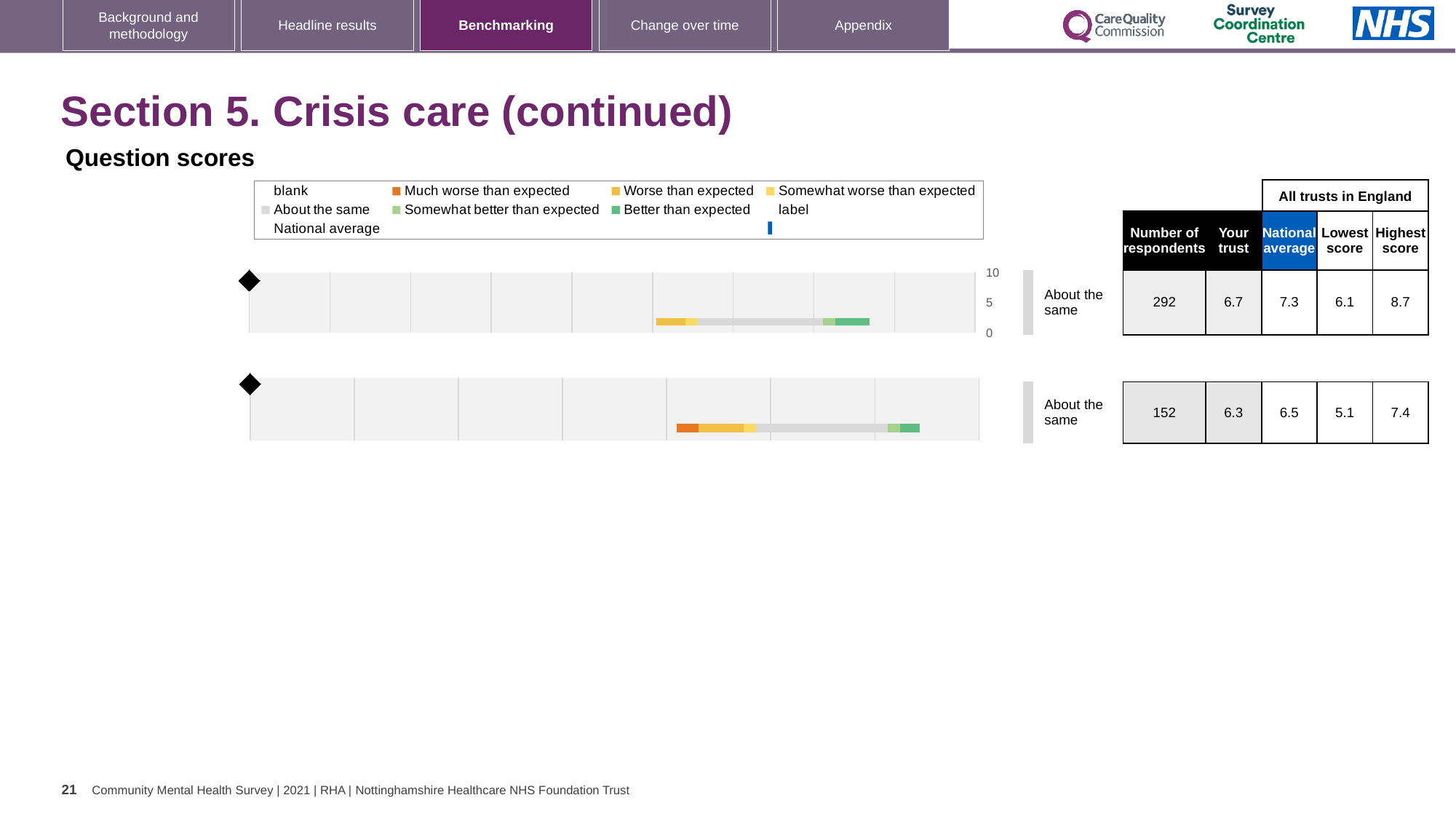
How many respondents are listed for the top chart? 292 In the bottom chart, what is the difference between the national average (6.5) and the 'Your trust' score (6.3)? 0.2 In the top chart, which is larger: the 'Your trust' score or the national average? National average In the top chart, what is the national average score? 7.3 What benchmark category is shown next to both charts? About the same In the top chart, what is the 'Your trust' score shown in the table? 6.7 In the bottom chart, what is the 'Your trust' score? 6.3 In the bottom chart, what is the highest score among all trusts in England? 7.4 How many question score charts are shown on the slide? 2 In the top chart, what is the difference between the highest score (8.7) and the lowest score (6.1)? 2.6 What kind of chart is used to show the question scores on this slide? Bar chart In the bottom chart, what is the lowest score among all trusts in England? 5.1